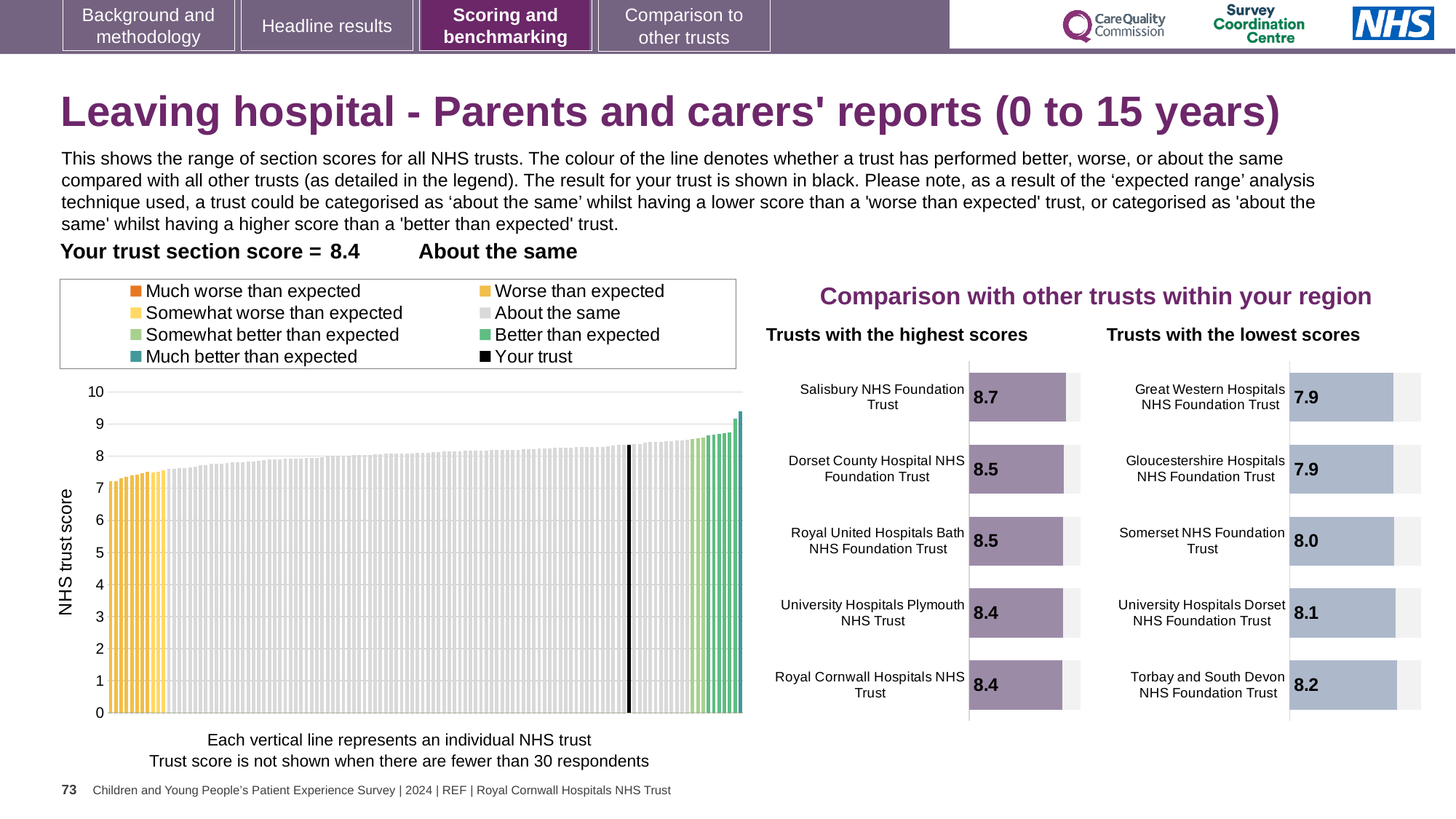
How many entries does the legend of the large chart on the left list? 8 In the 'Trusts with the lowest scores' chart, which has the larger score: Torbay and South Devon NHS Foundation Trust or Great Western Hospitals NHS Foundation Trust? Torbay and South Devon NHS Foundation Trust What kind of chart is the large chart on the left showing NHS trust scores? Bar chart How many trusts are listed in the 'Trusts with the highest scores' chart? 5 In the 'Trusts with the lowest scores' chart, what is the score for Somerset NHS Foundation Trust? 8.0 In the 'Trusts with the highest scores' chart, which trust has the highest score? Salisbury NHS Foundation Trust In the 'Trusts with the highest scores' chart, what is the score for Salisbury NHS Foundation Trust? 8.7 In the 'Trusts with the lowest scores' chart, what is the difference between the scores of Torbay and South Devon NHS Foundation Trust and Somerset NHS Foundation Trust? 0.2 In the 'Trusts with the highest scores' chart, what is the difference between the scores of Salisbury NHS Foundation Trust and Royal Cornwall Hospitals NHS Trust? 0.3 In the large chart on the left, do the trust scores rise or fall from left to right? Rise In the large chart on the left, is the value of the tallest bar greater or less than 9? greater In the 'Trusts with the lowest scores' chart, which trust has the highest score shown? Torbay and South Devon NHS Foundation Trust